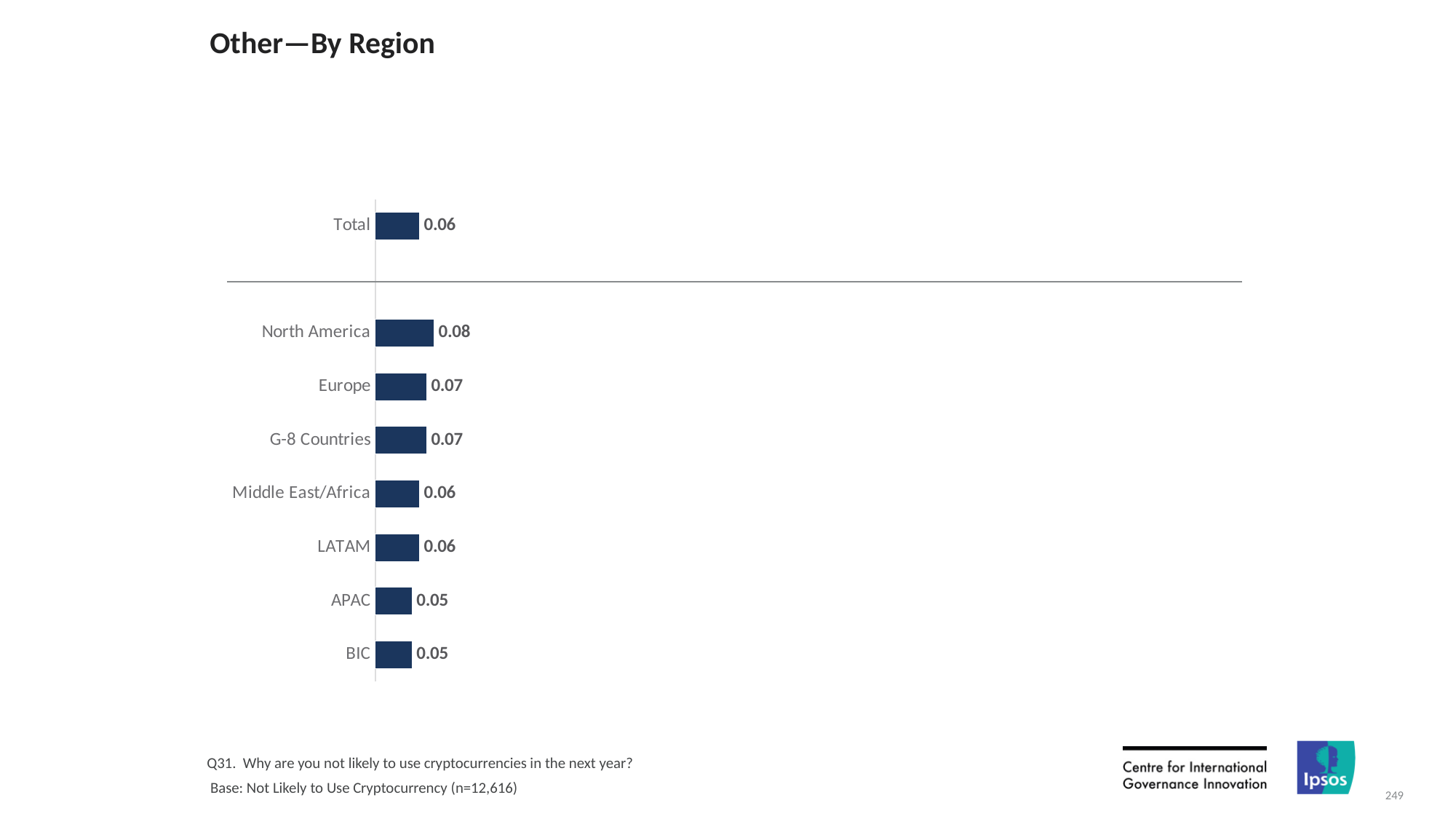
What is the value for Total? 0.06 What is the difference between the values for North America and APAC? 0.03 What is the value for Europe? 0.07 What is the value for North America? 0.08 What is the base size (n) stated at the bottom of the slide? 12,616 Which is larger, the value for North America or the value for Middle East/Africa? North America What is the difference between the values for Europe and LATAM? 0.01 Which region has the highest value? North America How many bars are shown on the chart, including Total? 8 What is the value for BIC? 0.05 What kind of chart is shown on the slide? Bar chart What is the title of the chart? Other—By Region